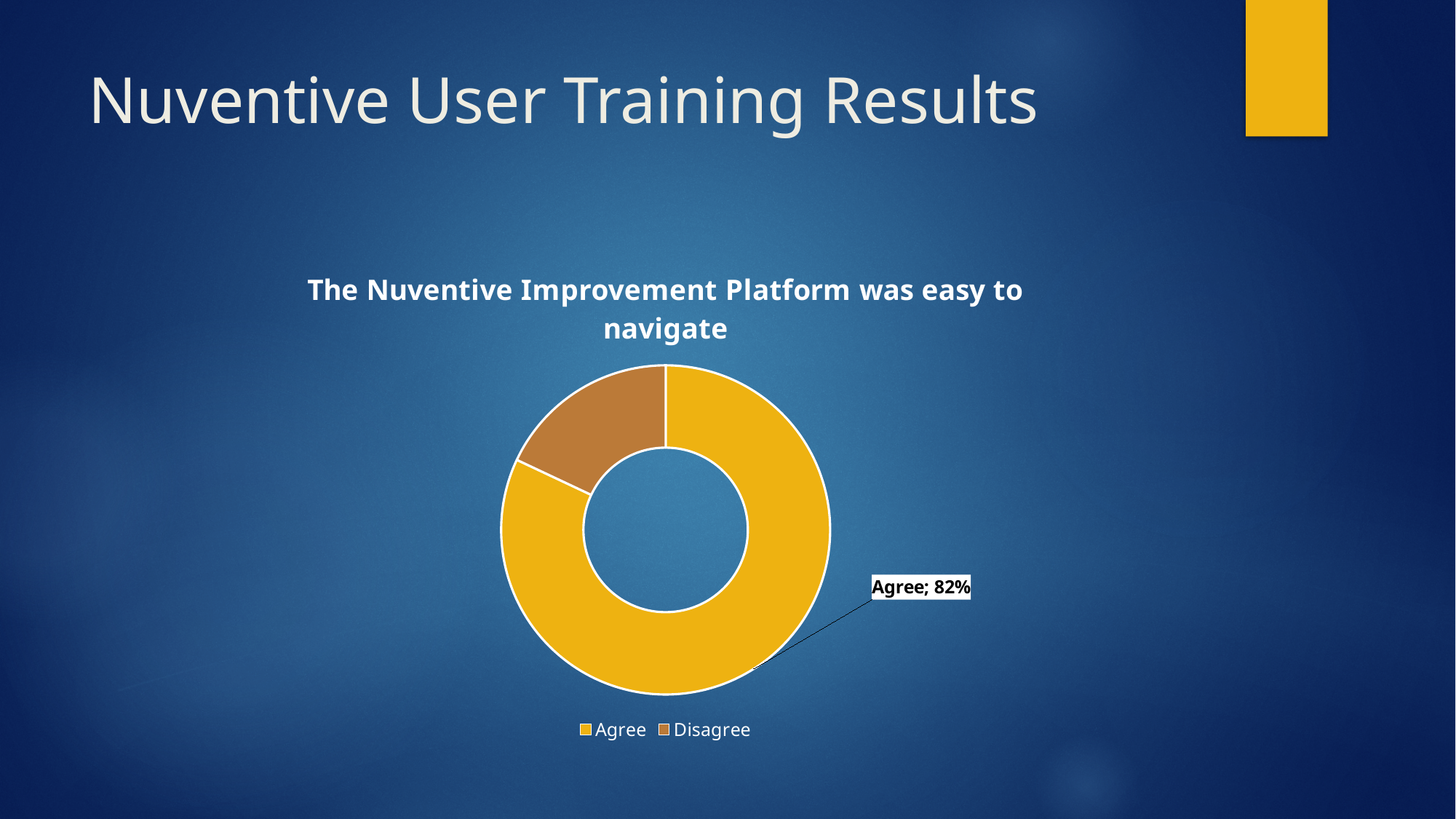
Which category has the largest share of the chart? Agree What colour represents the Disagree category in the chart? Brown/orange Which is larger, the Agree slice or the Disagree slice? Agree What percentage of respondents agreed that the Nuventive Improvement Platform was easy to navigate? 82% How many entries does the chart legend list? 2 What share of the chart does the Agree slice represent? 82% What kind of chart is shown on the slide? Doughnut (pie) chart What is the title of the chart? The Nuventive Improvement Platform was easy to navigate How many categories are shown in the chart? 2 Which category has the smallest share of the chart? Disagree